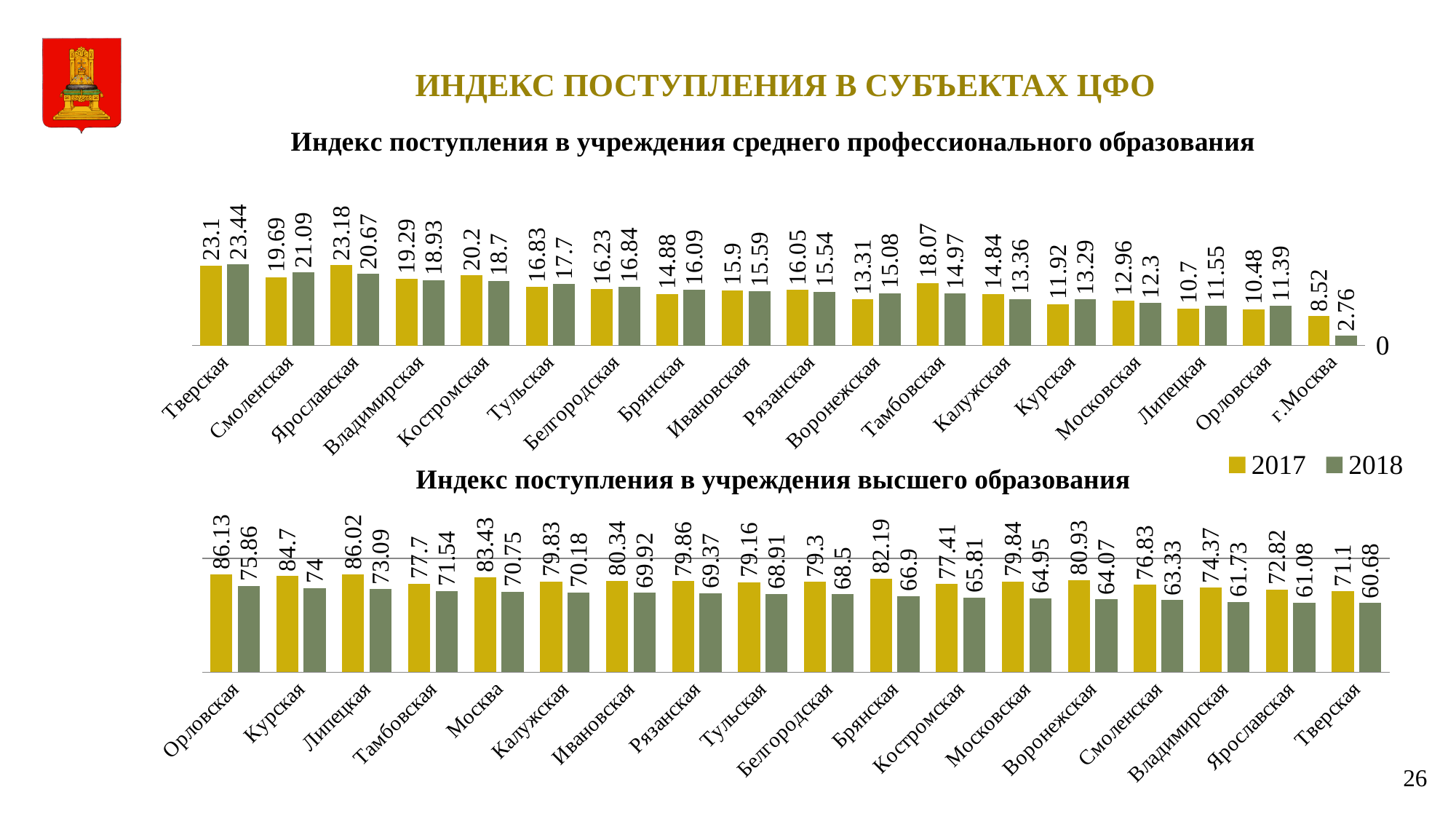
How many series does the legend list for the charts on the slide? 2 On the chart 'Индекс поступления в учреждения высшего образования', which region has the lowest 2018 value? Тверская On the chart 'Индекс поступления в учреждения высшего образования', how many regions are shown on the x axis? 18 On the chart 'Индекс поступления в учреждения среднего профессионального образования', which region has the lowest 2018 value? г.Москва On the chart 'Индекс поступления в учреждения среднего профессионального образования', what is the 2017 value for Тамбовская? 18.07 On the chart 'Индекс поступления в учреждения среднего профессионального образования', what is the 2018 value for Тверская? 23.44 On the chart 'Индекс поступления в учреждения среднего профессионального образования', which region has the highest 2018 value? Тверская On the chart 'Индекс поступления в учреждения среднего профессионального образования', which is larger for Ярославская: the 2017 value or the 2018 value? 2017 On the chart 'Индекс поступления в учреждения среднего профессионального образования', what is the difference between the 2018 and 2017 values for Тверская? 0.34 What type of chart is 'Индекс поступления в учреждения высшего образования'? Bar chart On the chart 'Индекс поступления в учреждения высшего образования', what is the difference between the 2017 and 2018 values for Орловская? 10.27 On the chart 'Индекс поступления в учреждения высшего образования', what is the 2018 value for Курская? 74